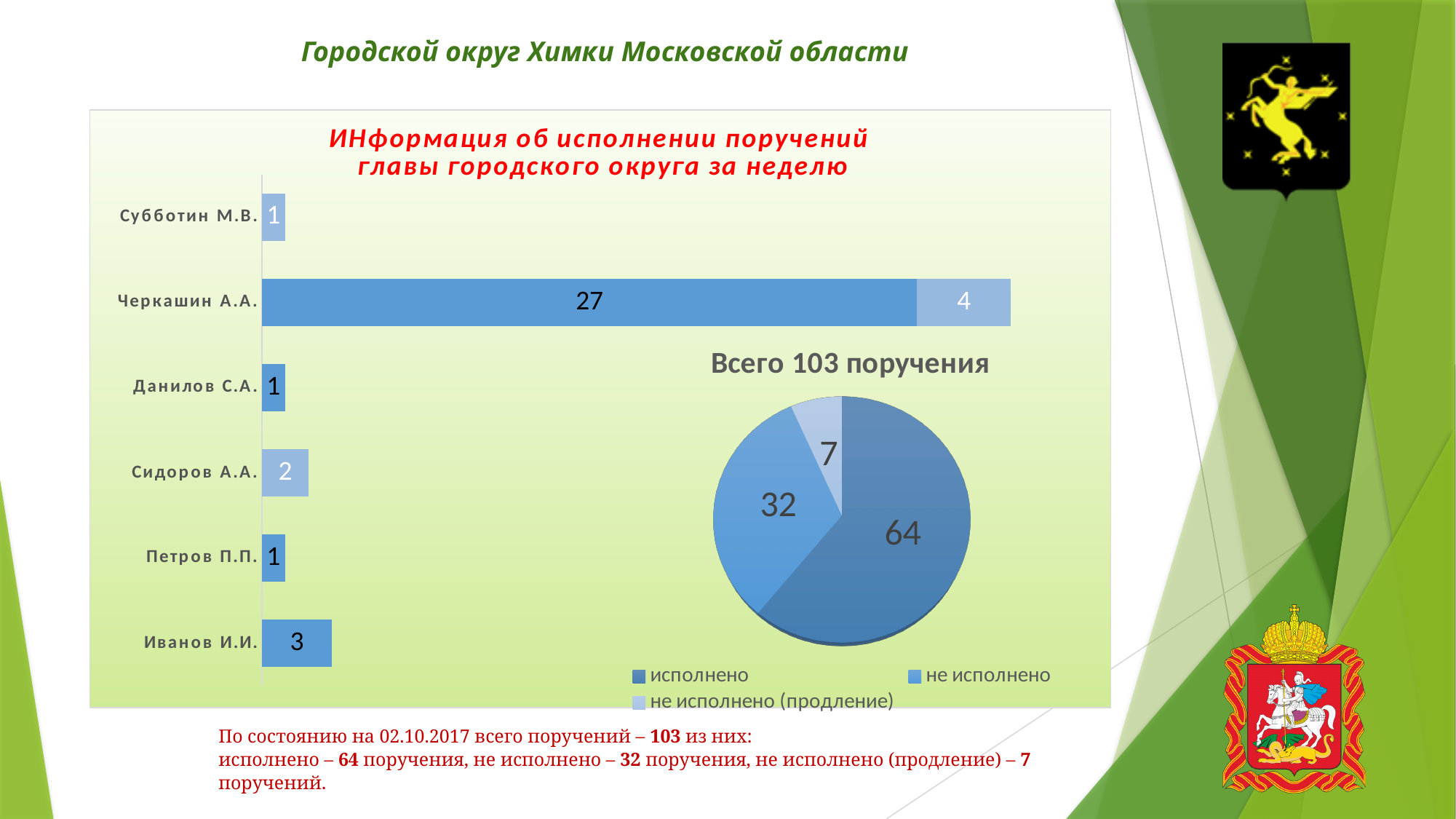
What kind of chart is the chart on the left listing people's names? bar chart In the bar chart on the left, what is the value of the larger segment of the bar for Черкашин А.А.? 27 In the bar chart on the left, what is the total of the stacked bar for Черкашин А.А.? 31 In the pie chart 'Всего 103 поручения', what is the difference between the 'исполнено' slice and the 'не исполнено' slice? 32 In the bar chart on the left, what is the value for Иванов И.И.? 3 In the pie chart 'Всего 103 поручения', which slice is the largest? исполнено (64) In the bar chart on the left, what is the value for Сидоров А.А.? 2 In the bar chart on the left, which person has the longest bar? Черкашин А.А. How many people are listed as categories in the bar chart on the left? 6 What kind of chart is the chart titled 'Всего 103 поручения'? pie chart In the pie chart 'Всего 103 поручения', what is the value of the smallest slice? 7 How many entries does the legend at the bottom of the chart area list? 3